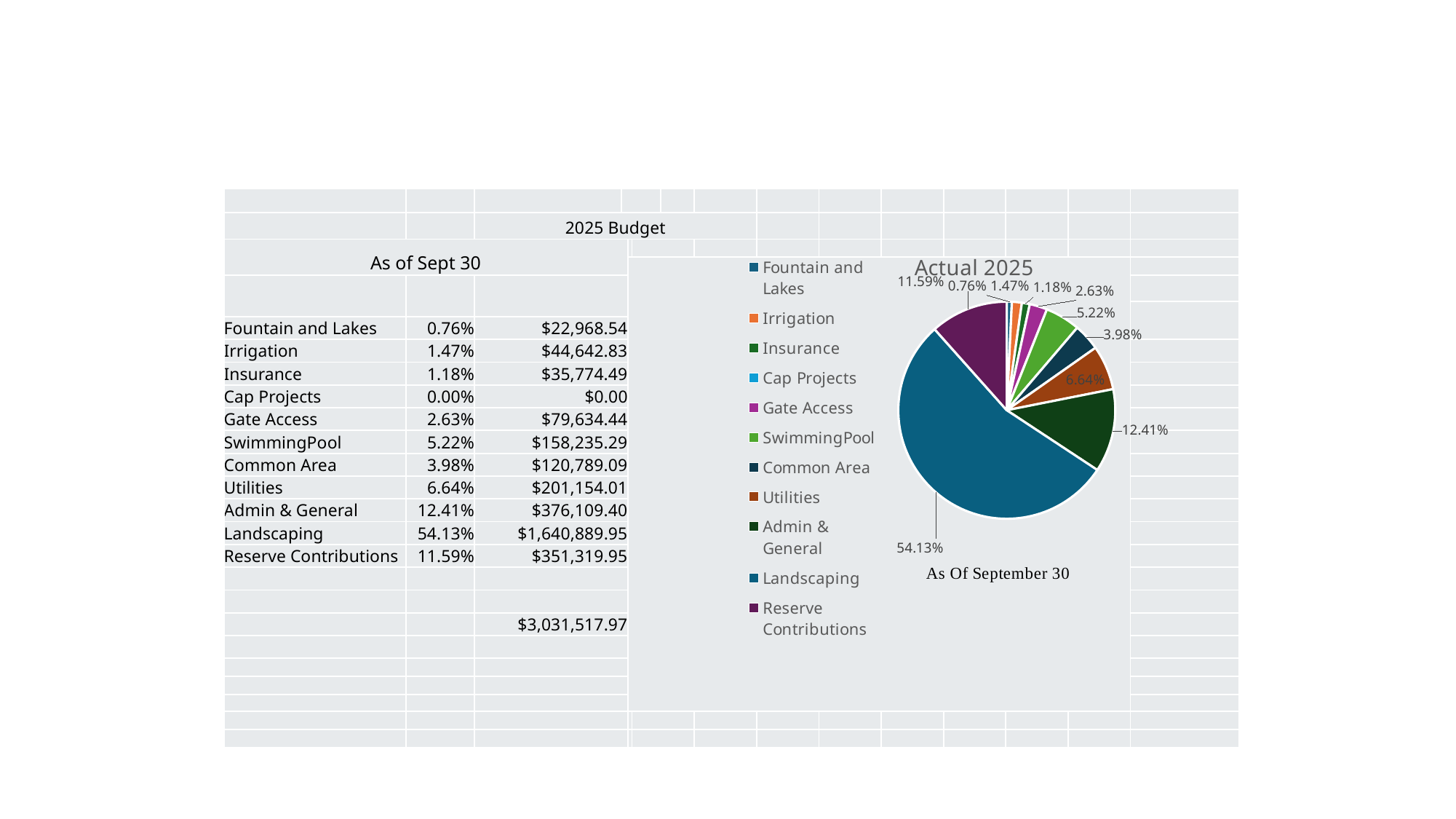
What is the difference in percentage points between Landscaping and Admin & General in the pie chart? 41.72% What kind of chart is shown on the slide? pie chart What is the value shown for Admin & General in the pie chart? 12.41% Which category has the largest slice of the pie chart? Landscaping What is the value shown for Utilities in the pie chart? 6.64% What is the title of the pie chart? Actual 2025 What share of the pie does Landscaping represent? 54.13% What is the value shown for SwimmingPool in the pie chart? 5.22% How many entries does the pie chart's legend list? 11 Which is larger in the pie chart, Admin & General or Reserve Contributions? Admin & General What is the value shown for Reserve Contributions in the pie chart? 11.59% Is the Landscaping slice greater or less than 50% of the pie? greater